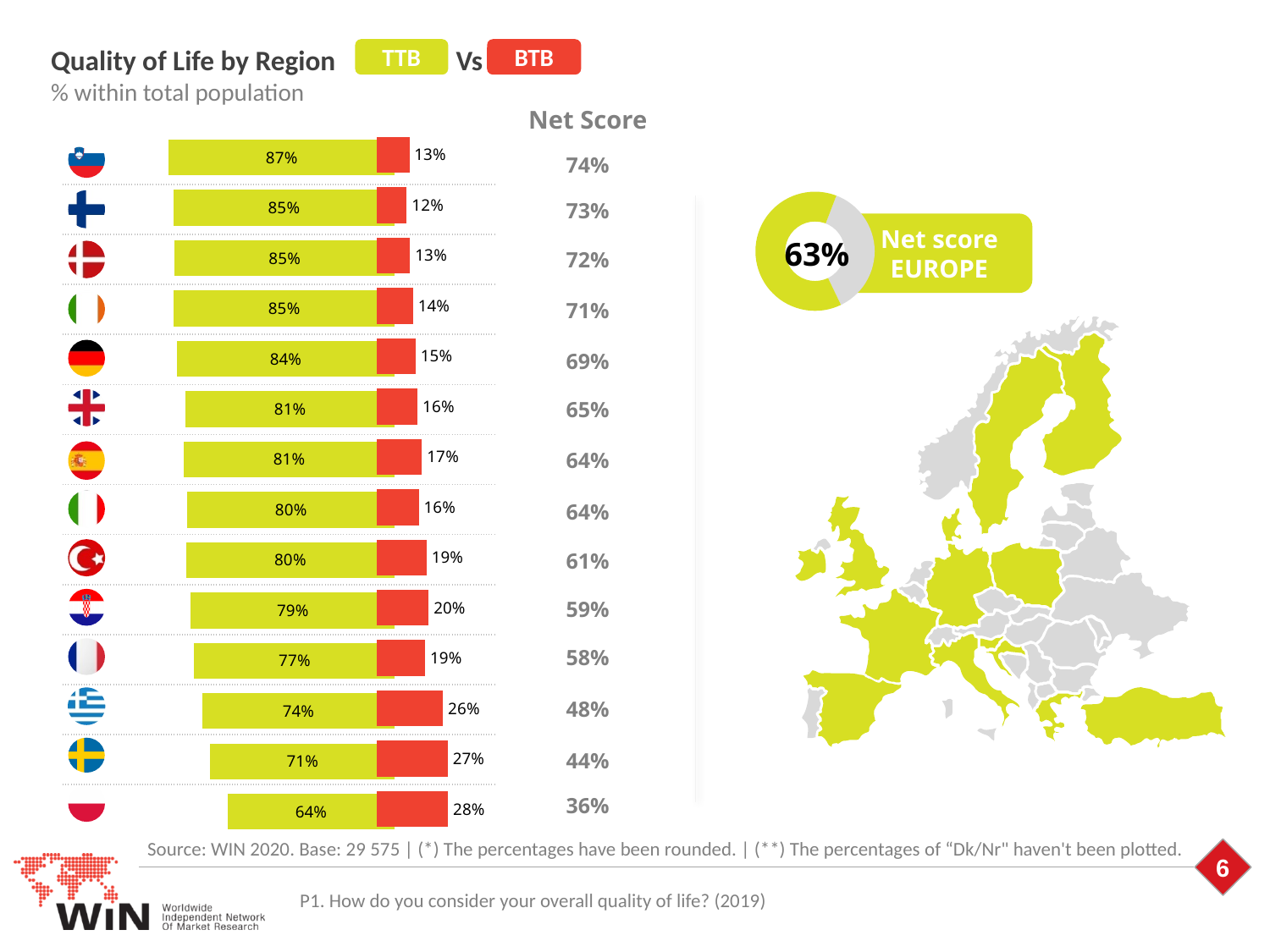
Do the Net Score values rise or fall going from the top row to the bottom row of the bar chart? fall In the bar chart, what is the Net Score for the row whose TTB value is 84%? 69% In the bar chart, what is the difference between the TTB and BTB values in the top row? 74% In the bar chart, what is the BTB value for the bottom row? 28% What kind of chart is used to show the TTB and BTB values by region? bar chart How many regions (rows) are plotted in the bar chart? 14 In the bar chart, what is the TTB value for the top row? 87% What is the lowest Net Score shown in the bar chart? 36% What value is shown in the donut chart labelled Net score EUROPE? 63% In the bar chart, which row has the larger TTB value, the top row or the bottom row? the top row How many series does the legend at the top of the slide list? 2 What is the highest TTB value shown in the bar chart? 87%